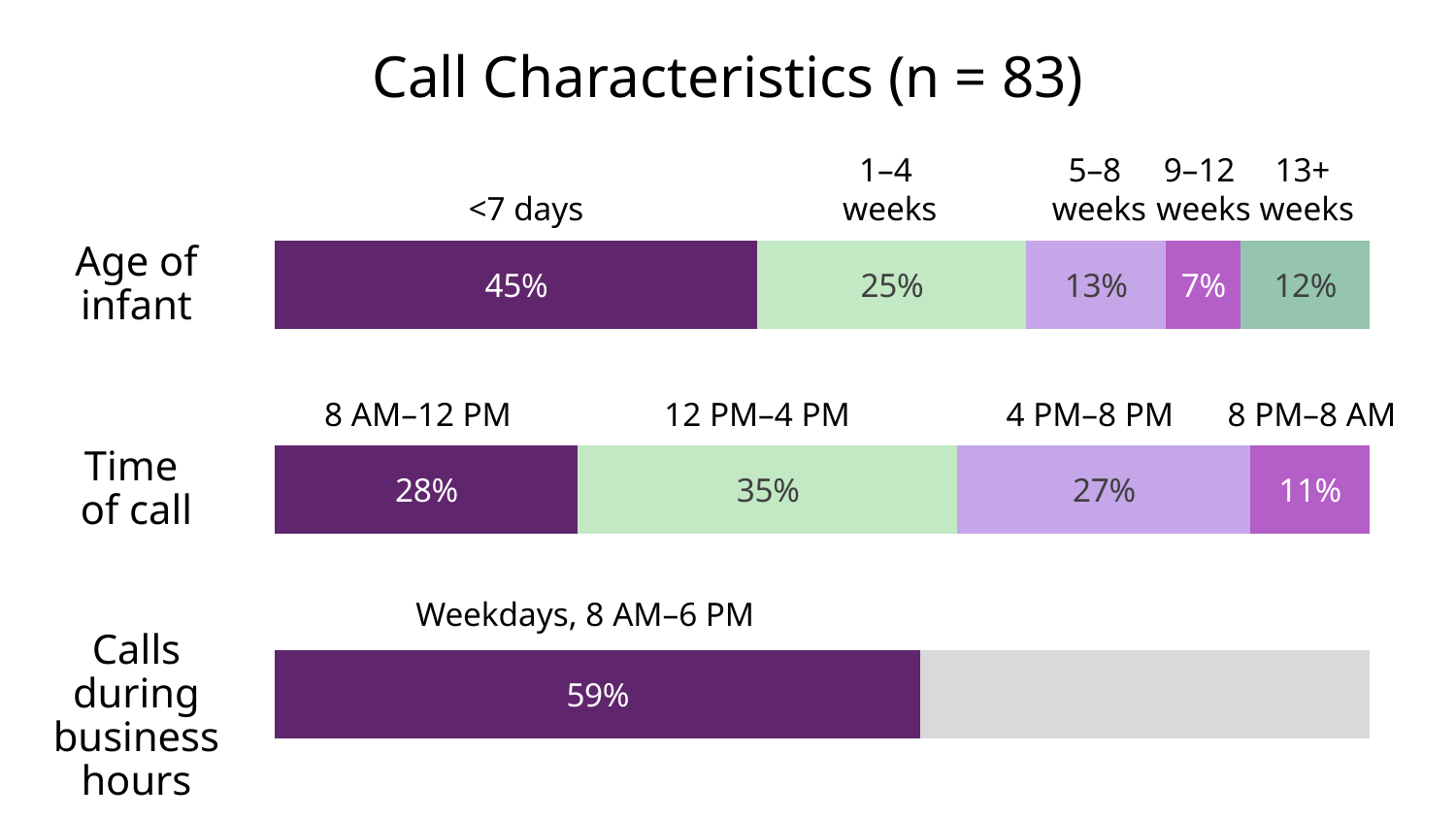
What type of chart is used on this slide? Stacked bar chart How many age-of-infant segments are shown in the 'Age of infant' bar? 5 In the 'Age of infant' bar, what is the difference in percentage points between the <7 days segment and the 1–4 weeks segment? 20 Which age group of infant accounts for the largest share of calls? <7 days In the 'Time of call' bar, what percentage of calls occurred between 12 PM and 4 PM? 35% In the 'Time of call' bar, which is larger: the 8 AM–12 PM segment or the 4 PM–8 PM segment? 8 AM–12 PM Which time-of-call period accounts for the smallest share of calls? 8 PM–8 AM What percentage of calls occurred during business hours (Weekdays, 8 AM–6 PM)? 59% How many time periods are shown in the 'Time of call' bar? 4 In the 'Age of infant' bar, what percentage of calls were for infants aged 9–12 weeks? 7% In the 'Age of infant' bar, what percentage of calls were for infants aged <7 days? 45% What is the title of the chart on this slide? Call Characteristics (n = 83)